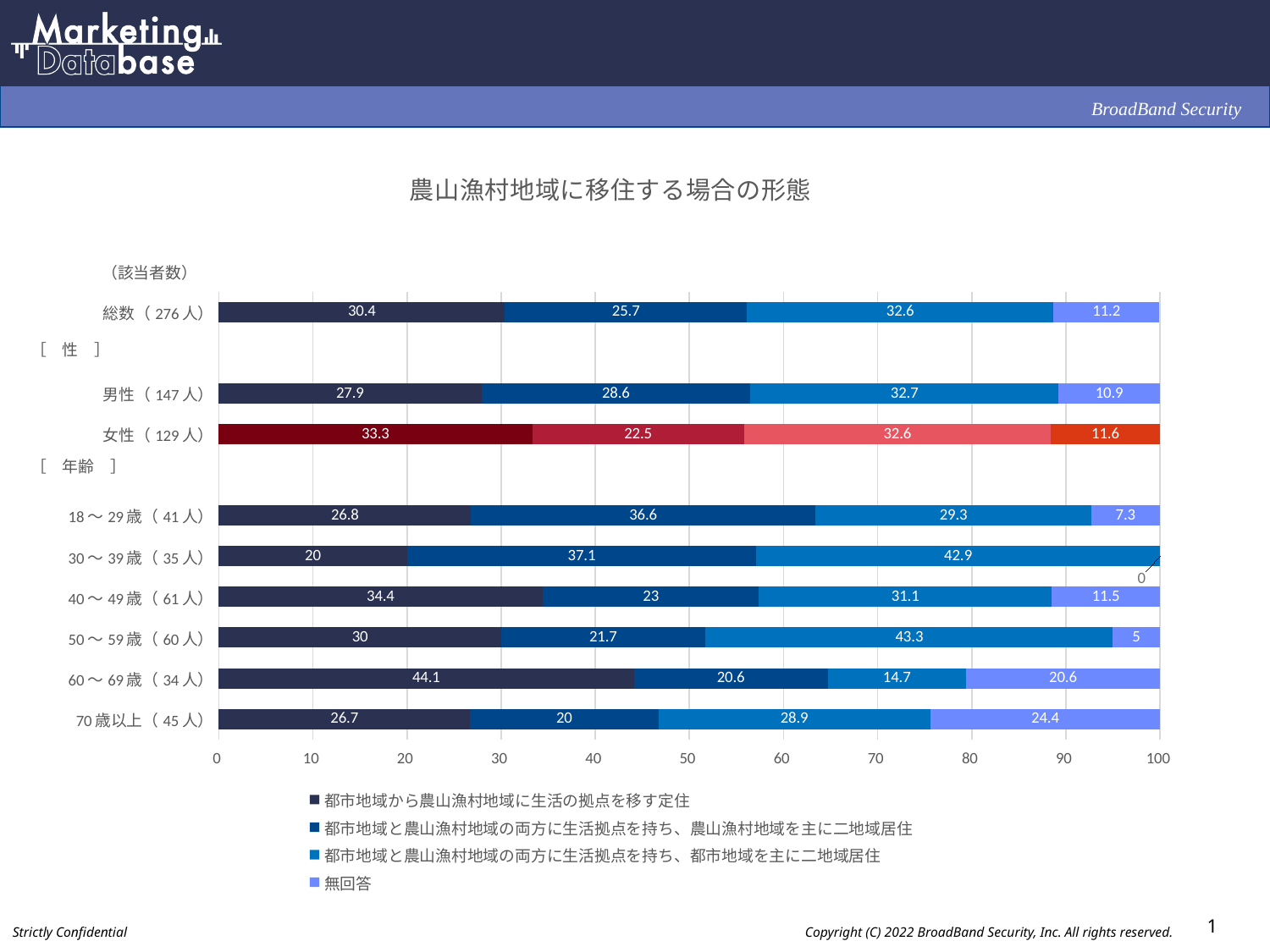
Which age group has the highest value for 「都市地域から農山漁村地域に生活の拠点を移す定住」? 60～69歳 (34人) What kind of chart is shown on the slide? Stacked bar chart Which age group has the lowest value for 「無回答」? 30～39歳 (35人) What is the title of the chart? 農山漁村地域に移住する場合の形態 What is the value of 「無回答」 for 70歳以上 (45人)? 24.4 What is the difference between 男性 (147人) and 女性 (129人) for 「都市地域から農山漁村地域に生活の拠点を移す定住」? 5.4 How many category bars are plotted in the chart? 9 What is the value of 「都市地域と農山漁村地域の両方に生活拠点を持ち、都市地域を主に二地域居住」 for 50～59歳 (60人)? 43.3 What is the value of 「都市地域から農山漁村地域に生活の拠点を移す定住」 for 総数 (276人)? 30.4 What is the total of the stacked bar for 40～49歳 (61人)? 100 Which is larger for 「都市地域と農山漁村地域の両方に生活拠点を持ち、農山漁村地域を主に二地域居住」: 18～29歳 (41人) or 70歳以上 (45人)? 18～29歳 (41人) How many series does the legend list? 4